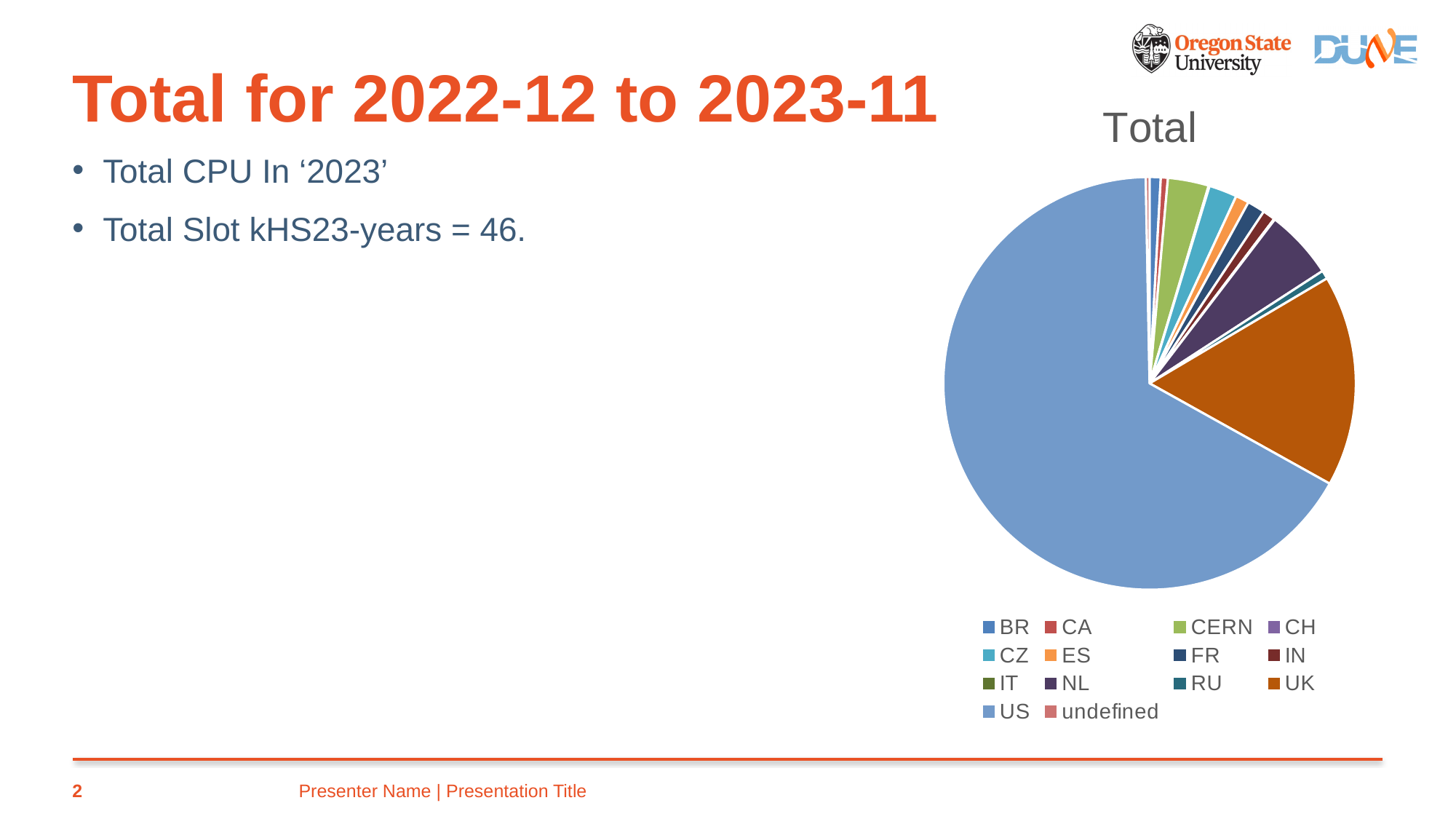
Which slice is larger, CERN or CZ? CERN Which slice is larger, US or UK? US Which category has the second-largest slice of the pie? UK Which category has the largest slice of the pie? US What kind of chart is shown on the slide? pie chart Does the US slice account for more or less than half of the pie? more Which slice is larger, NL or CERN? NL How many categories does the chart's legend list? 14 What is the title of the chart? Total What colour is the US slice in the pie chart? light blue